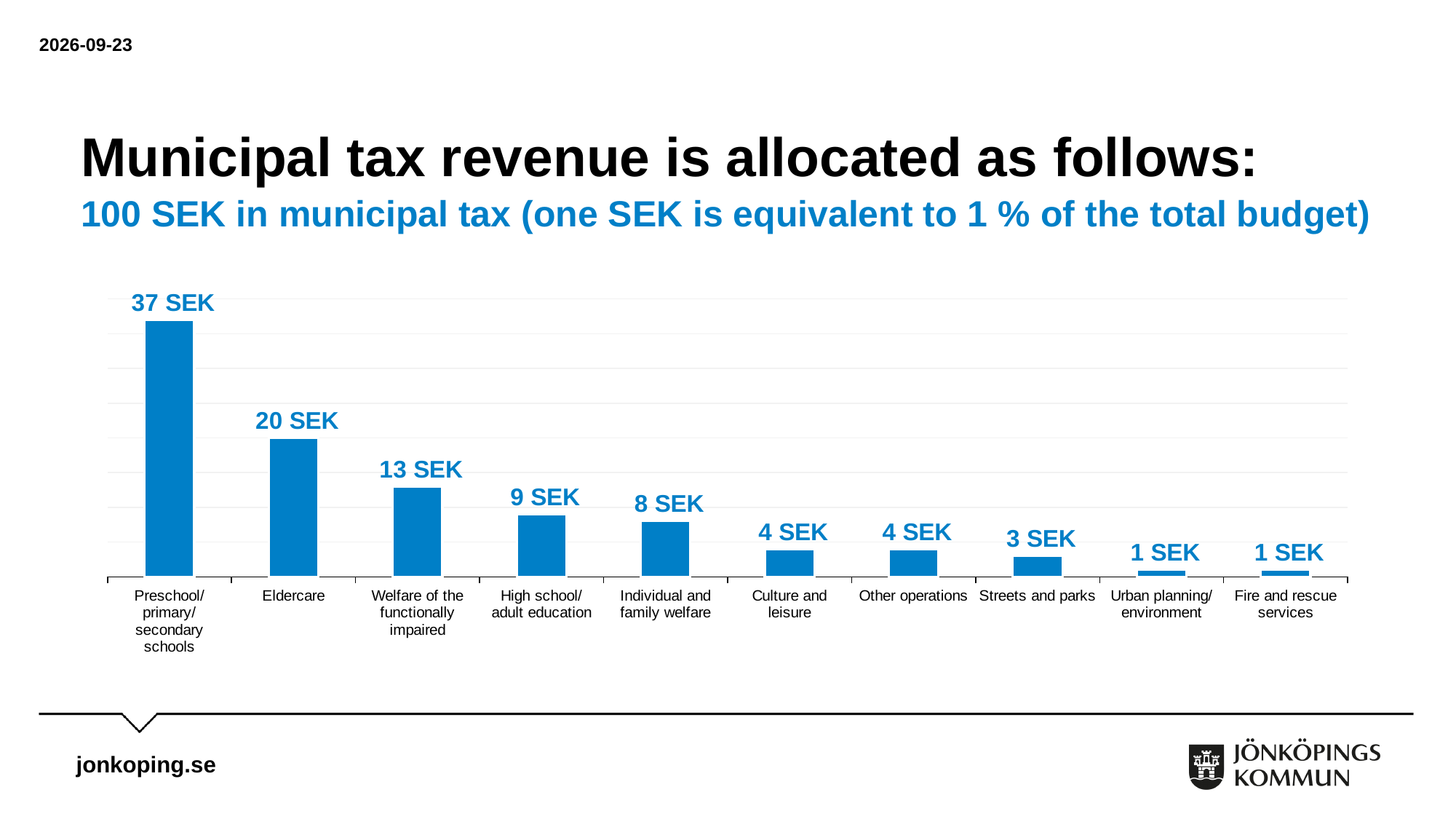
What is the value for Streets and parks? 3 SEK How many SEK are allocated to Eldercare? 20 SEK Which is larger, the allocation for Culture and leisure or for Streets and parks? Culture and leisure What is the title of the slide above the chart? Municipal tax revenue is allocated as follows: What is the value for Welfare of the functionally impaired? 13 SEK How many categories are shown in the chart? 10 Which category receives the largest allocation? Preschool/primary/secondary schools Do the values rise or fall from left to right across the chart? Fall What is the difference between High school/adult education and Individual and family welfare? 1 SEK How many SEK go to Individual and family welfare? 8 SEK What kind of chart is shown on the slide? Bar chart What is the difference between the allocation for Preschool/primary/secondary schools and Eldercare? 17 SEK